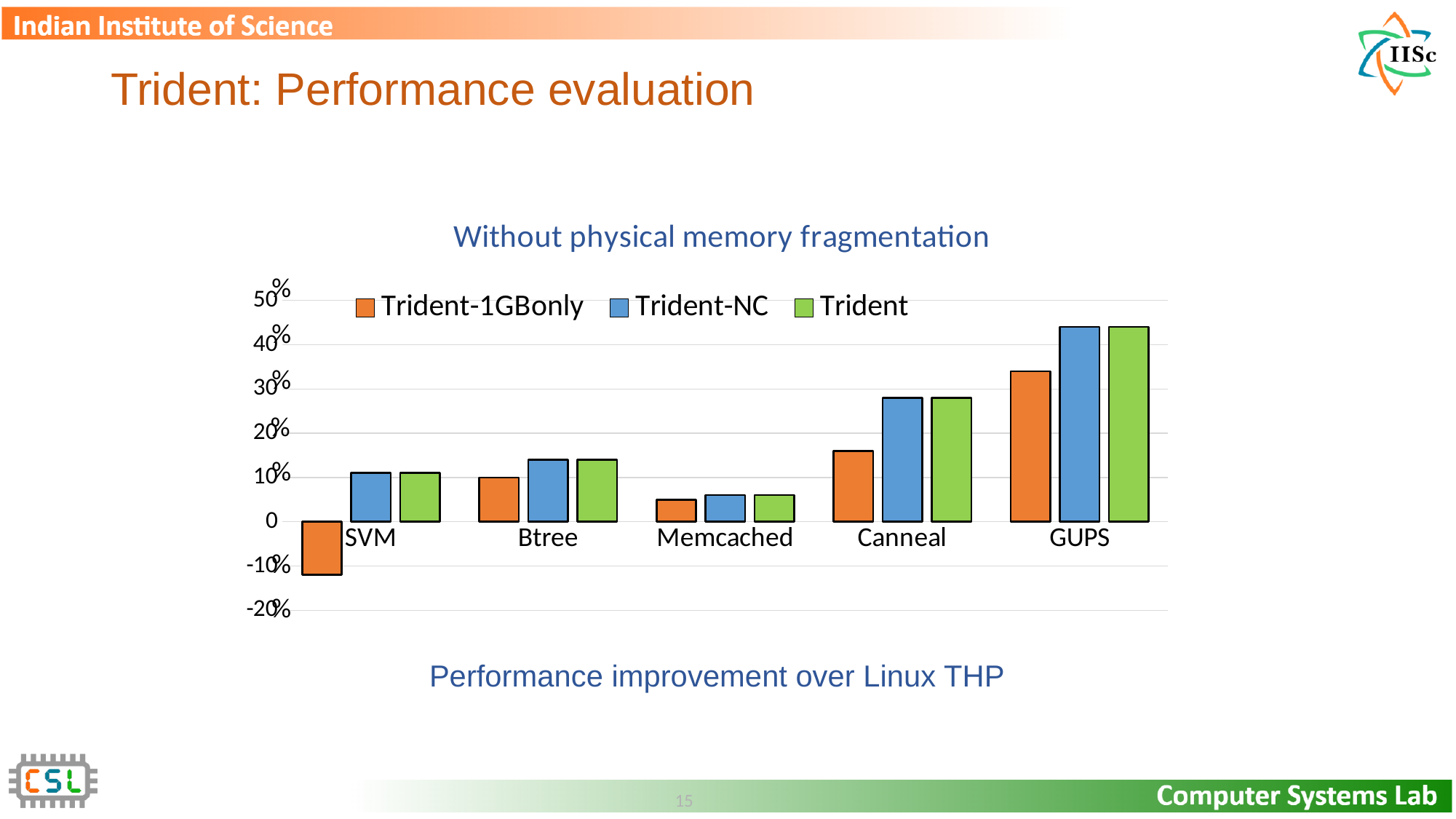
How many series does the chart legend list? 3 Which is larger: the Trident-NC value for Canneal or the Trident-NC value for Btree? Canneal What is the title shown above the chart? Without physical memory fragmentation Which workload has the lowest Trident-1GBonly value in the chart? SVM Is the Trident-NC value for Canneal greater or less than 20%? greater Is the Trident-NC value for GUPS greater or less than 40%? greater What kind of chart is shown on the slide? bar chart Which is larger: the Trident-1GBonly value for GUPS or the Trident-1GBonly value for Canneal? GUPS Is the Trident-1GBonly value for Memcached greater or less than 10%? less Which workload has the highest Trident value in the chart? GUPS How many workload categories are shown on the x axis of the chart? 5